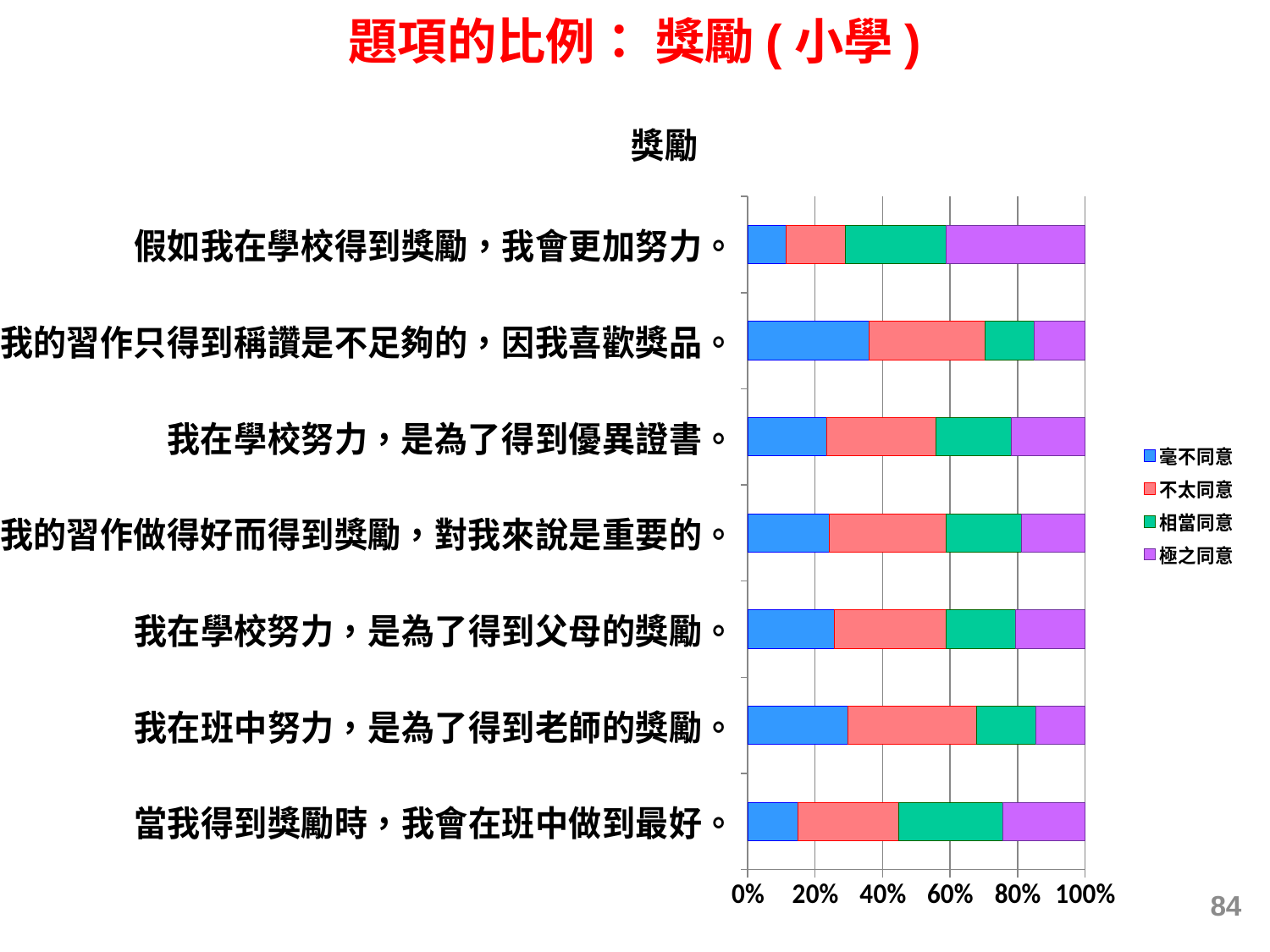
How many series does the legend list? 4 Is the 毫不同意 share for "我在班中努力，是為了得到老師的獎勵。" greater or less than 20%? greater Is the 極之同意 share for "假如我在學校得到獎勵，我會更加努力。" greater or less than 20%? greater How many statements (categories) are plotted in the chart? 7 Which statement has the largest 極之同意 share? 假如我在學校得到獎勵，我會更加努力。 What do the four segments of each bar add up to? 100% What are the four legend entries of the chart? 毫不同意, 不太同意, 相當同意, 極之同意 What kind of chart is shown on the slide? Stacked bar chart Is the 毫不同意 share for "假如我在學校得到獎勵，我會更加努力。" greater or less than 20%? less What is the title shown above the chart? 獎勵 Which has the larger 毫不同意 share: "我的習作只得到稱讚是不足夠的，因我喜歡獎品。" or "假如我在學校得到獎勵，我會更加努力。"? 我的習作只得到稱讚是不足夠的，因我喜歡獎品。